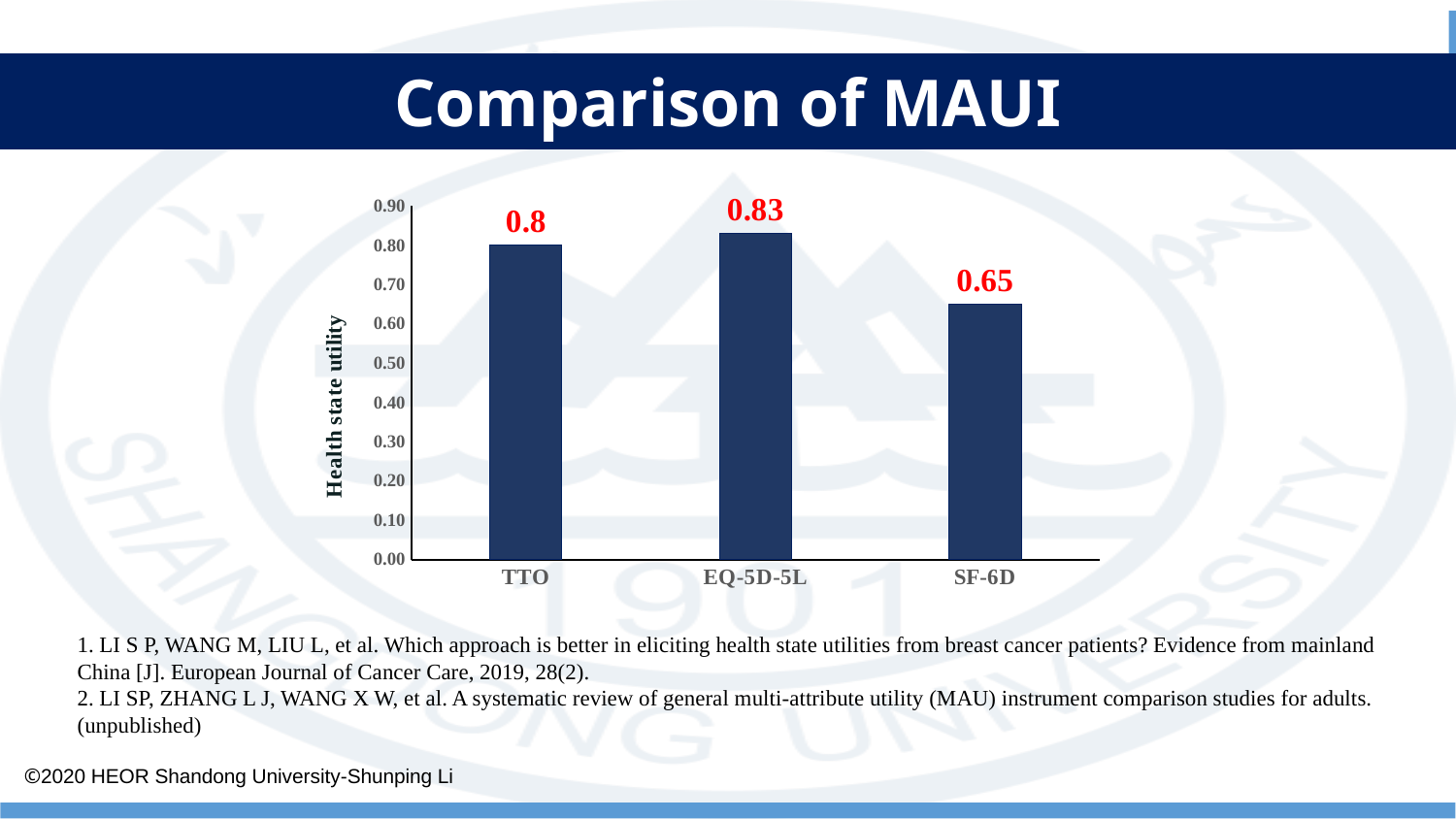
Is the value for SF-6D greater or less than 0.70? less How many instruments are compared in the chart? 3 Which has a larger health state utility, TTO or SF-6D? TTO Which instrument has the lowest health state utility? SF-6D What is the health state utility value for SF-6D? 0.65 What kind of chart is shown on the slide? bar chart What is the label of the vertical axis? Health state utility What is the health state utility value for EQ-5D-5L? 0.83 What is the difference between the TTO and SF-6D values? 0.15 What is the health state utility value for TTO? 0.8 Which instrument has the highest health state utility? EQ-5D-5L What is the difference between the EQ-5D-5L and SF-6D values? 0.18